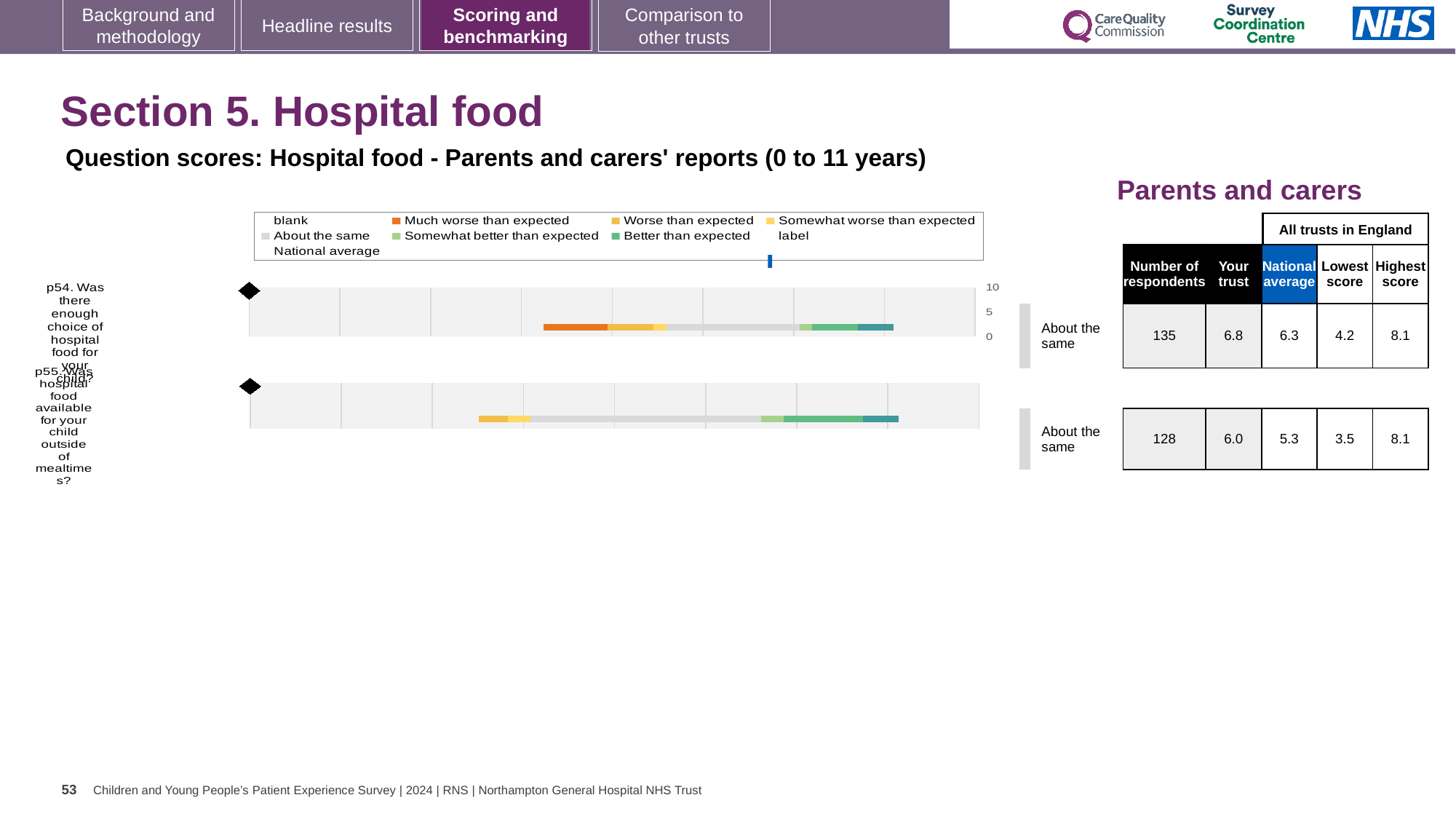
What is the highest score among all trusts in England for p55? 8.1 What is the difference between the highest and lowest scores for p55? 4.6 What kind of chart is used to show the question scores for hospital food? bar chart What is the national average score for p55 (hospital food available outside of mealtimes)? 5.3 Which question has the higher 'Your trust' score, p54 or p55? p54 What is the lowest score among all trusts in England for p54? 4.2 What benchmark category is shown for p55 (hospital food available outside of mealtimes)? About the same How many questions (categories) are plotted in the hospital food chart? 2 What is the number of respondents for p54 (enough choice of hospital food for your child)? 135 For p54, which is larger: the 'Your trust' score or the national average? Your trust What is the maximum value shown on the chart's score axis? 10 What is the 'Your trust' score for p54 (enough choice of hospital food)? 6.8